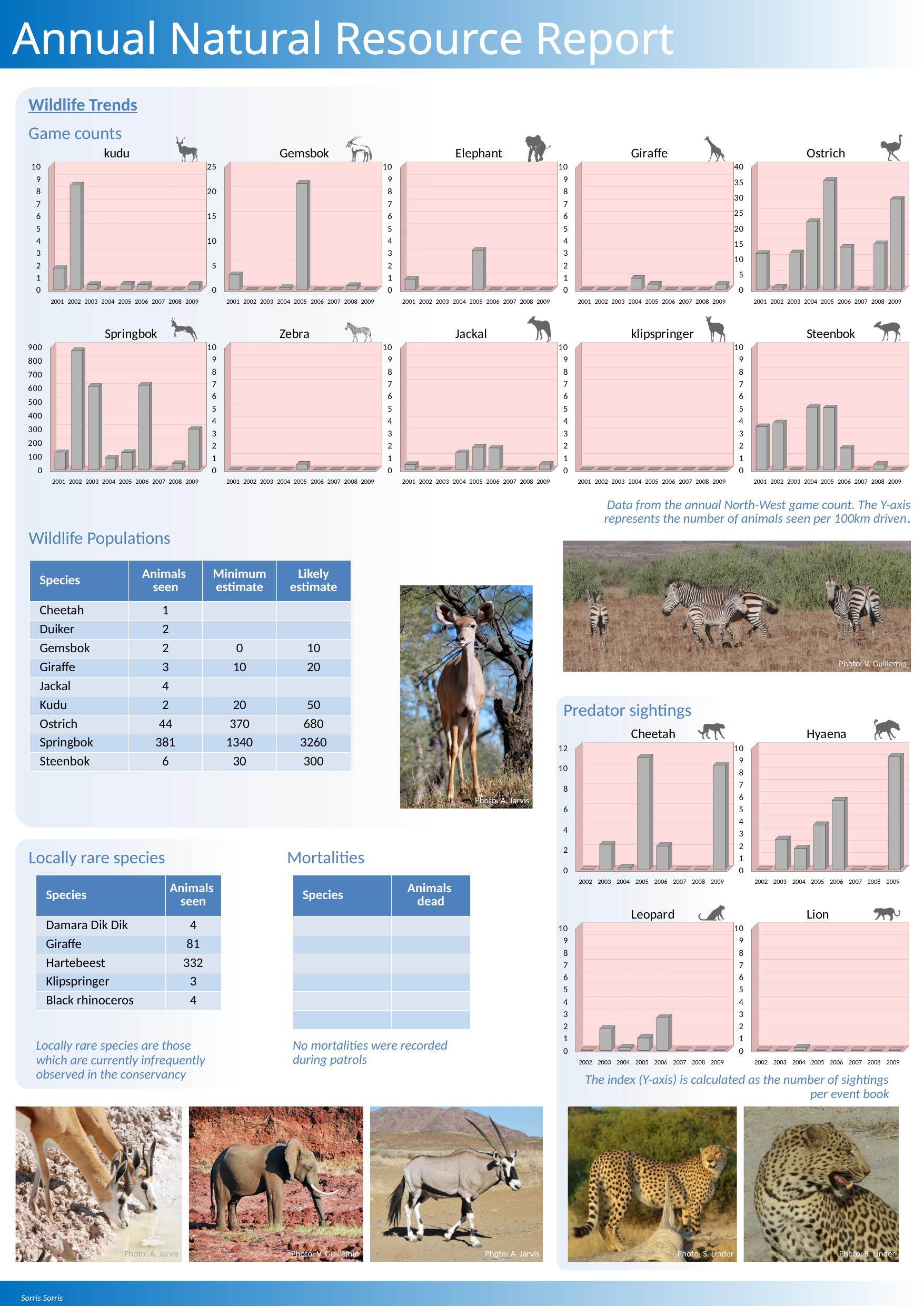
In the Elephant game count chart, which year has the highest value? 2005 What kind of chart is the kudu game count chart? bar chart In the Springbok game count chart, is the value for 2002 greater or less than 800? greater How many years are shown on the x axis of the Cheetah predator sightings chart? 8 In the Ostrich game count chart, which year has the highest value? 2005 In the kudu game count chart, is the value for 2002 greater or less than 5? greater In the Springbok game count chart, which year has the highest value? 2002 In the Ostrich game count chart, which is larger, the value for 2004 or the value for 2006? 2004 In the Gemsbok game count chart, is the value for 2005 greater or less than 20? greater